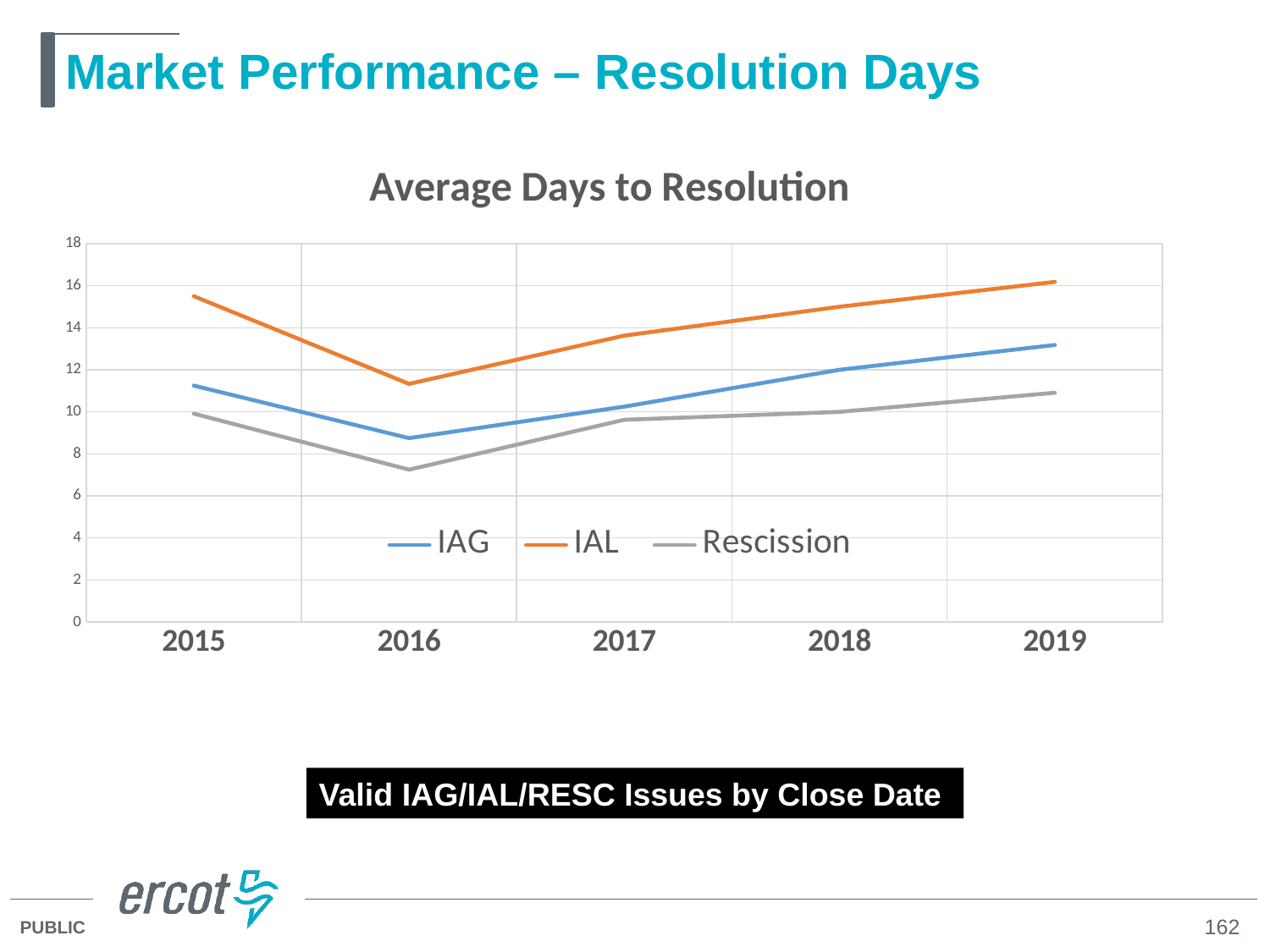
What is the title of the chart? Average Days to Resolution In 2015, which is larger, the IAG value or the Rescission value? IAG In which year is the IAL value lowest? 2016 In which year is the IAG value highest? 2019 What kind of chart is shown on the slide? line chart Which series has the highest value in every year shown? IAL Does the IAL line rise or fall from 2016 to 2019? rise How many years are shown on the x axis? 5 Is the IAL value for 2015 greater or less than 14? greater Is the Rescission value for 2016 greater or less than 8? less Is the IAG value for 2019 greater or less than 12? greater How many series does the legend list? 3